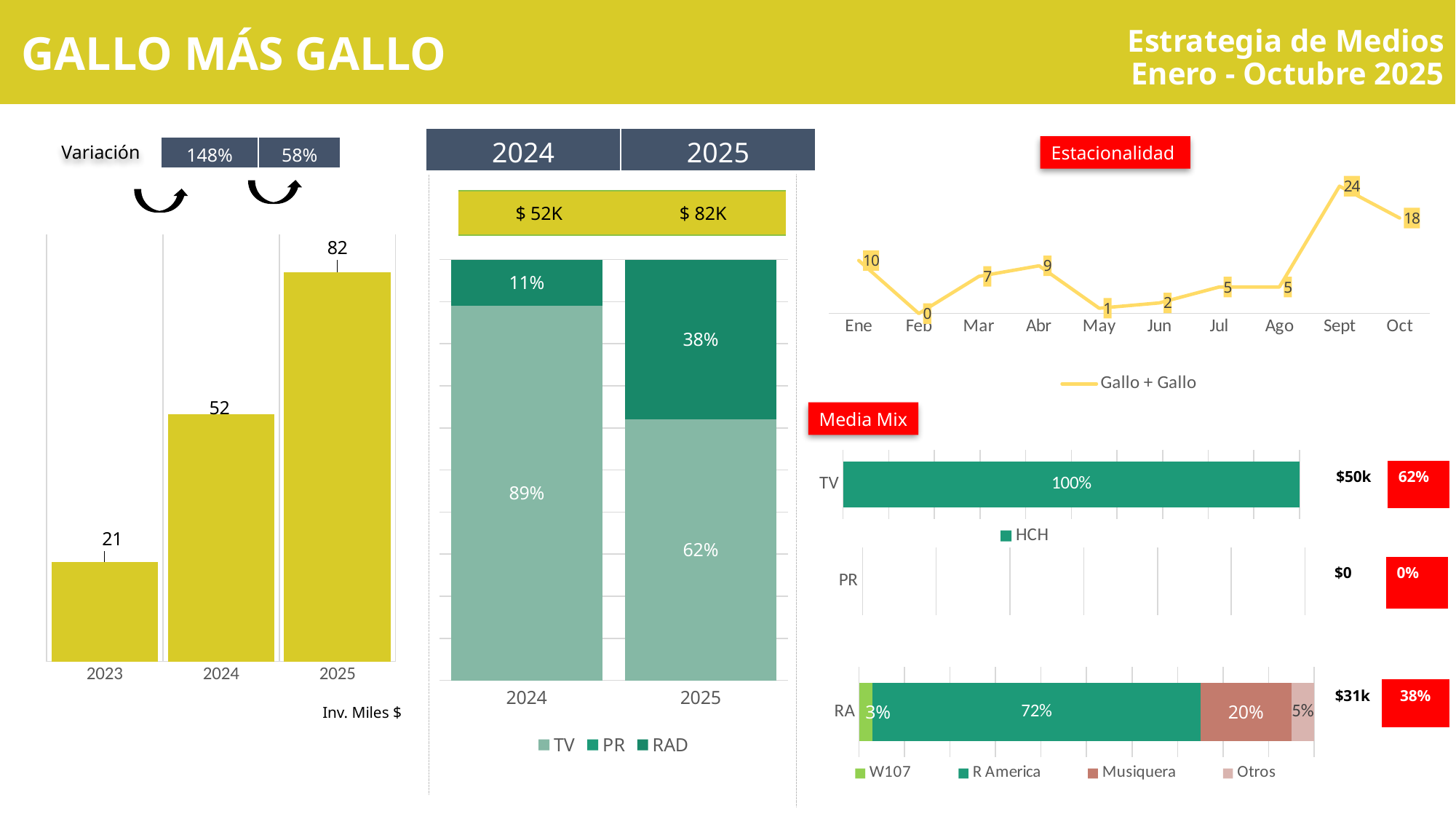
In the Estacionalidad chart, what is the value for Abr? 9 In the stacked bar chart for 2024 and 2025, what share does RAD have in 2024? 11% What kind of chart is the Estacionalidad chart? line chart In the bar chart on the left (Inv. Miles $), what is the difference between the 2025 and 2024 values? 30 In the Media Mix chart, what share does R America have in the RA bar? 72% In the stacked bar chart for 2024 and 2025, how many series does the legend list? 3 In the bar chart on the left (Inv. Miles $), what is the value for 2025? 82 In the bar chart on the left (Inv. Miles $), which year has the lowest value? 2023 In the stacked bar chart for 2024 and 2025, what share does TV have in 2025? 62% In the Estacionalidad chart, which month has the highest value? Sept In the Media Mix chart, which is larger in the RA bar: Musiquera or W107? Musiquera In the bar chart on the left (Inv. Miles $), how many years are shown? 3